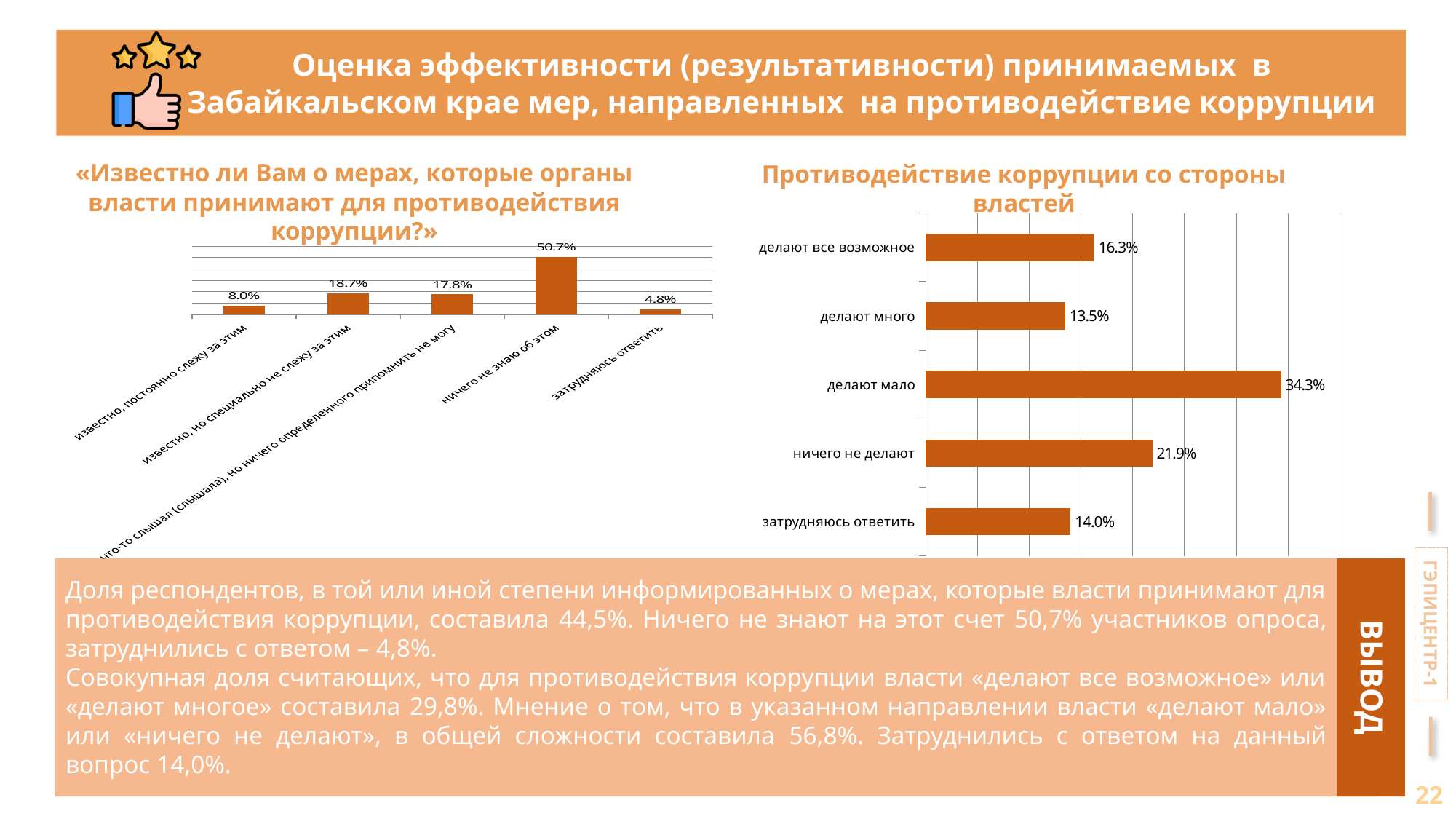
In the right chart («Противодействие коррупции со стороны властей»), what is the value for «делают мало»? 34.3% In the right chart («Противодействие коррупции со стороны властей»), what is the difference between «делают мало» and «ничего не делают»? 12.4% In the right chart («Противодействие коррупции со стороны властей»), which category has the highest value? делают мало In the left chart («Известно ли Вам о мерах...»), what is the difference between «известно, но специально не слежу за этим» and «что-то слышал (слышала), но ничего определенного припомнить не могу»? 0.9% In the left chart («Известно ли Вам о мерах...»), which category has the lowest value? затрудняюсь ответить In the left chart («Известно ли Вам о мерах...»), how many categories are shown? 5 In the left chart («Известно ли Вам о мерах...»), what is the value for «ничего не знаю об этом»? 50.7% What type of chart is the right chart («Противодействие коррупции со стороны властей»)? bar chart In the right chart («Противодействие коррупции со стороны властей»), what is the value for «ничего не делают»? 21.9% In the right chart («Противодействие коррупции со стороны властей»), which category has the lowest value? делают много In the right chart («Противодействие коррупции со стороны властей»), which is larger: «делают все возможное» or «затрудняюсь ответить»? делают все возможное In the left chart («Известно ли Вам о мерах...»), what is the value for «известно, постоянно слежу за этим»? 8.0%